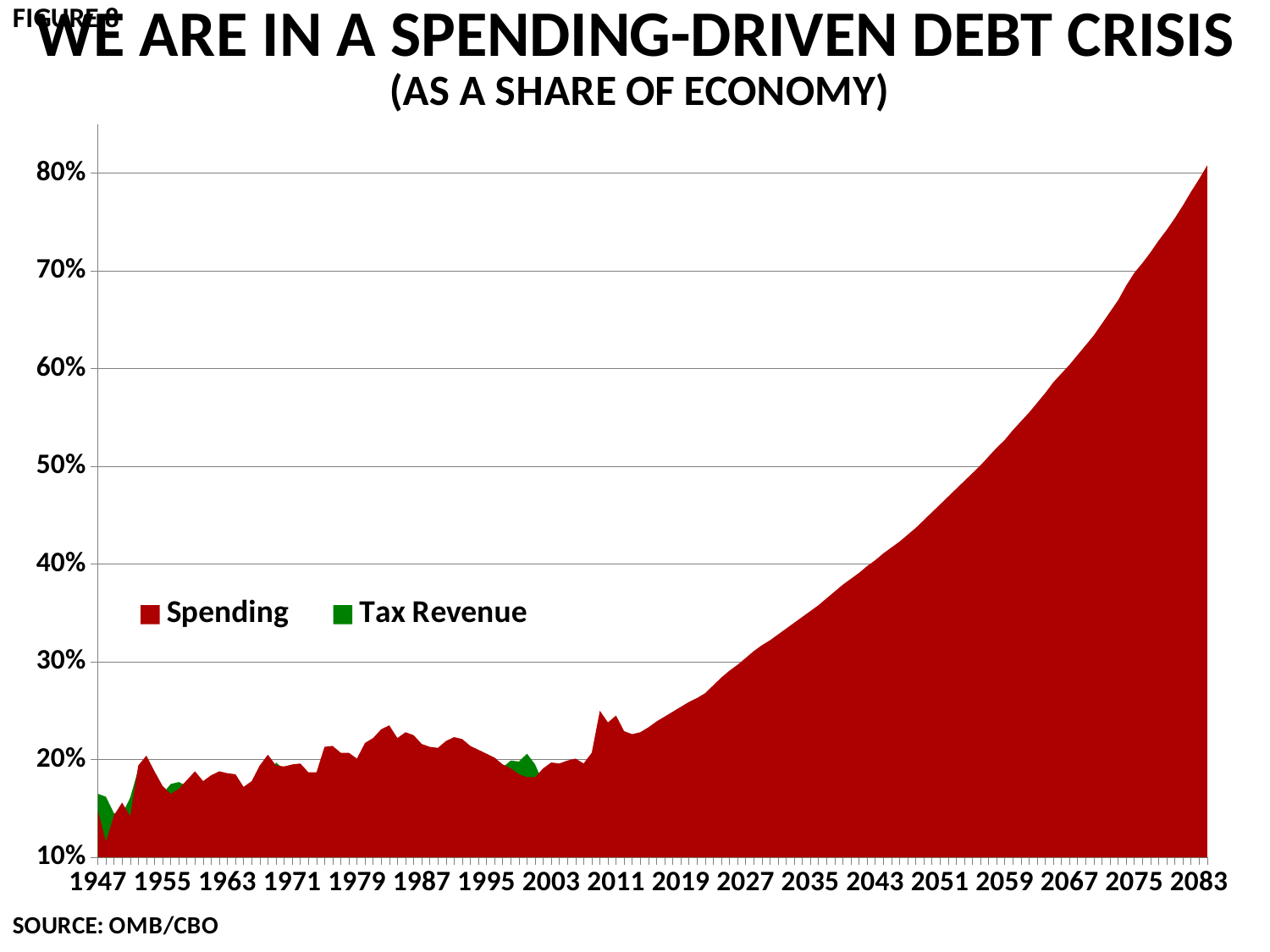
In which year shown on the x axis is Spending at its highest? 2083 How many year labels are shown on the x axis? 18 Does Spending rise or fall along the x axis from 2019 to 2083? Rise What are the two series named in the legend? Spending and Tax Revenue Is the value for Spending in 2051 greater or less than 50%? less Is the value for Spending in 2083 greater or less than 70%? greater Which colour represents Spending in the chart? Red Which is larger, Spending in 2083 or Spending in 1947? Spending in 2083 Is the value for Spending in 2035 greater or less than 40%? less What kind of chart is shown on the slide? Area chart How many series does the chart's legend list? 2